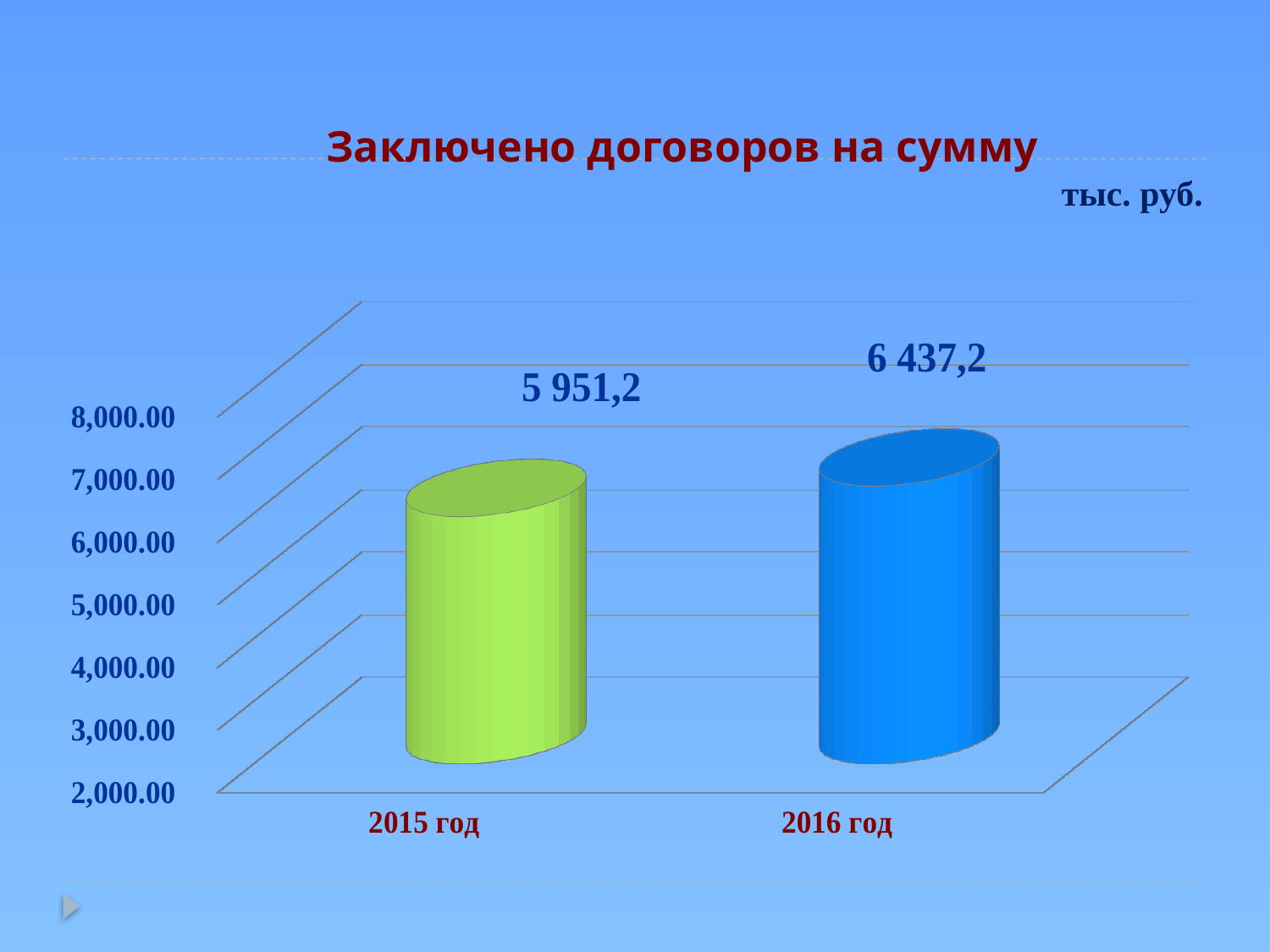
What is the difference between the values for 2016 год and 2015 год? 486,0 Which year has the lowest value? 2015 год Which year has the highest value? 2016 год Is the value for 2015 год greater or less than 5,000.00? greater Is the value for 2016 год greater or less than 7,000.00? less What is the value for 2015 год? 5 951,2 What is the title of the chart? Заключено договоров на сумму Which is larger, the value for 2015 год or the value for 2016 год? 2016 год What is the value for 2016 год? 6 437,2 Do the values rise or fall from 2015 год to 2016 год? rise What kind of chart is shown on the slide? bar chart How many categories are shown on the x axis? 2